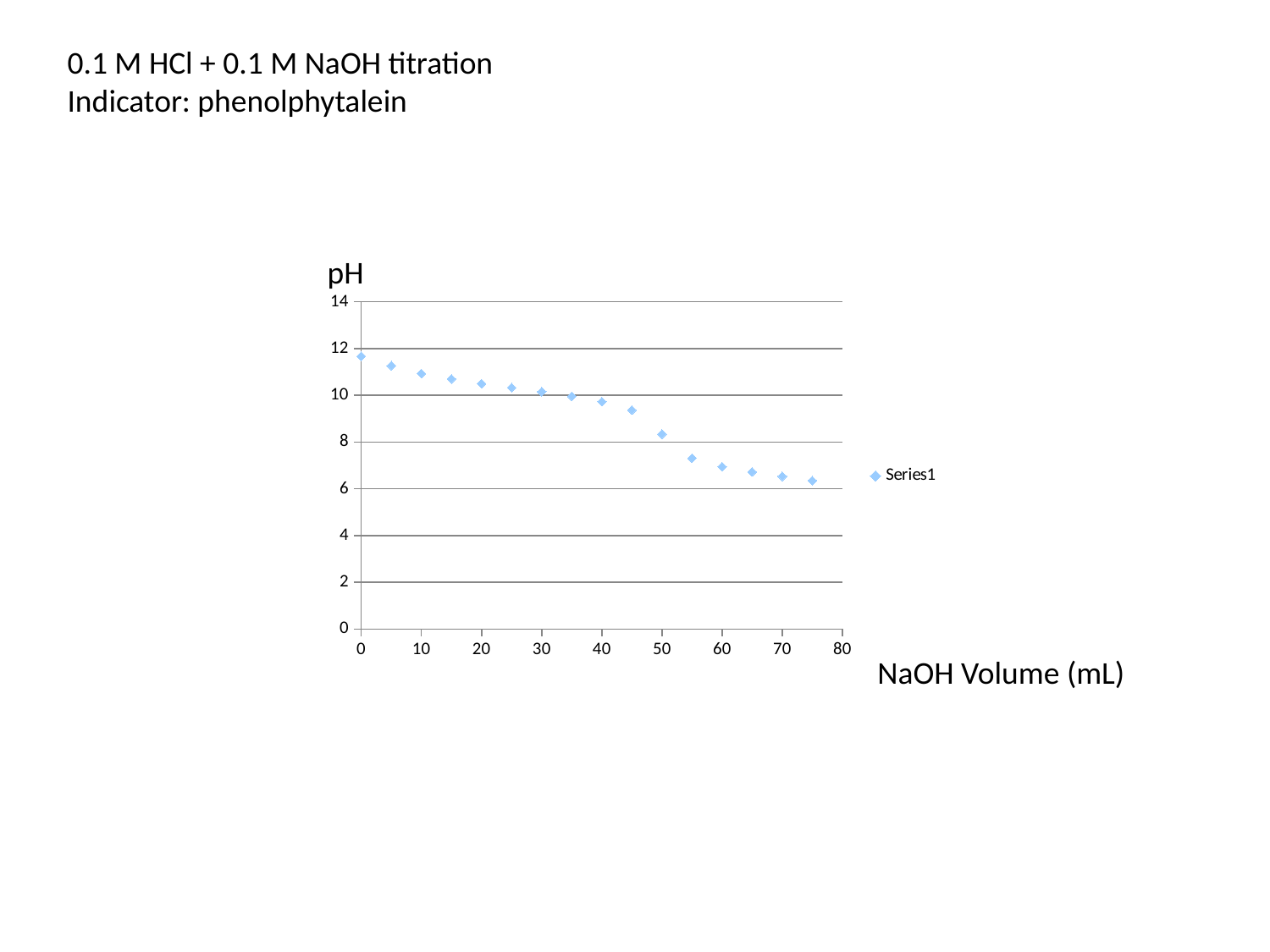
At which NaOH volume is the pH highest? 0 Do the pH values rise or fall as NaOH volume increases along the x axis? fall How many series does the legend list? 1 Is the pH at 75 mL NaOH greater or less than 8? less Is the pH at 50 mL NaOH greater or less than 10? less Which has the higher pH: 20 mL NaOH or 60 mL NaOH? 20 mL NaOH Is the pH at 0 mL NaOH greater or less than 10? greater At which NaOH volume is the pH lowest? 75 What kind of chart is shown on the slide? scatter chart How many data points are plotted on the chart? 16 What is the x-axis title of the chart? NaOH Volume (mL) What is the label of the series in the legend? Series1